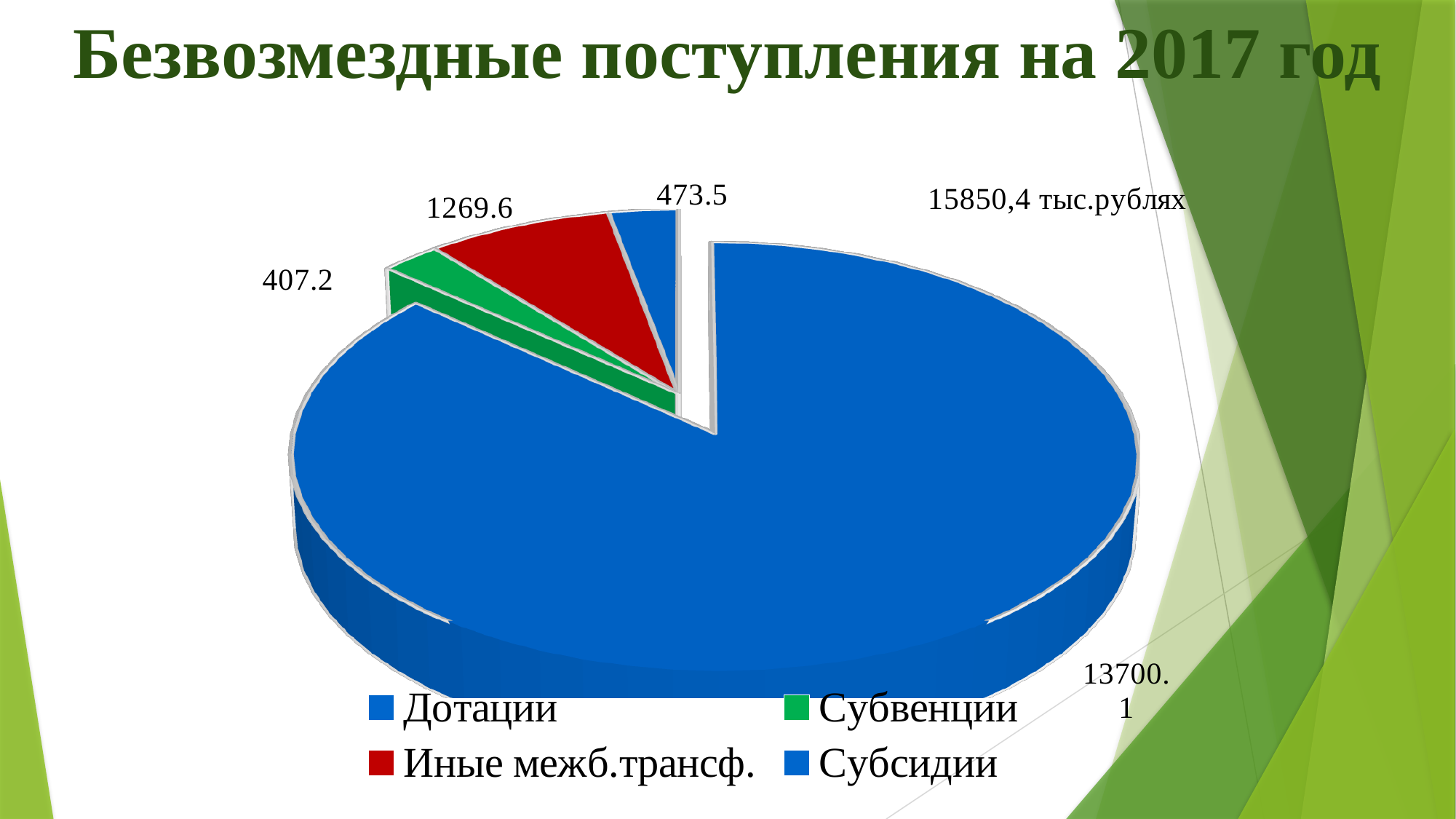
Which category has the largest slice of the pie? Дотации How many categories does the legend list? 4 What kind of chart is shown on the slide? pie chart What is the value for Субвенции? 407.2 What is the difference between the values for Субсидии and Субвенции? 66.3 What is the value for Дотации? 13700.1 What is the value for Субсидии? 473.5 Which is larger, the value for Иные межб.трансф. or the value for Субвенции? Иные межб.трансф. What is the difference between the values for Иные межб.трансф. and Субсидии? 796.1 What total amount is printed on the slide next to the pie chart? 15850,4 тыс.рублях What is the value for Иные межб.трансф.? 1269.6 Which category has the smallest slice of the pie? Субвенции